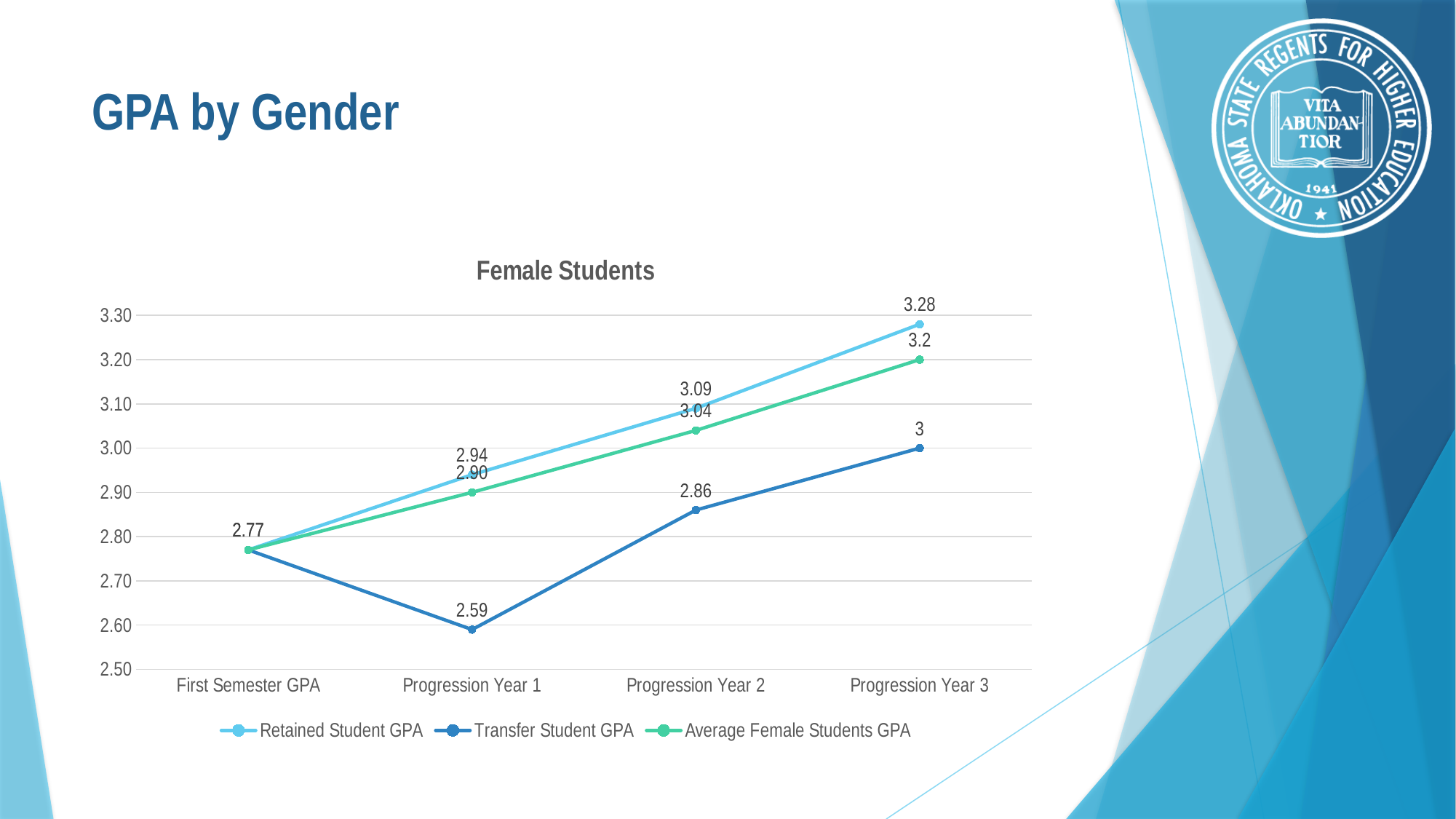
Which series has the highest value at Progression Year 3? Retained Student GPA Does the Retained Student GPA rise or fall from First Semester GPA to Progression Year 3? rise What is the title of the chart? Female Students How many categories are shown on the x axis? 4 What is the Transfer Student GPA at Progression Year 3? 3 What is the Average Female Students GPA at Progression Year 2? 3.04 What is the difference between the Retained Student GPA and the Transfer Student GPA at Progression Year 2? 0.23 At which category is the Transfer Student GPA lowest? Progression Year 1 How many series does the legend list? 3 What kind of chart is shown on the slide? line chart What is the Retained Student GPA at Progression Year 3? 3.28 What is the Transfer Student GPA at Progression Year 1? 2.59